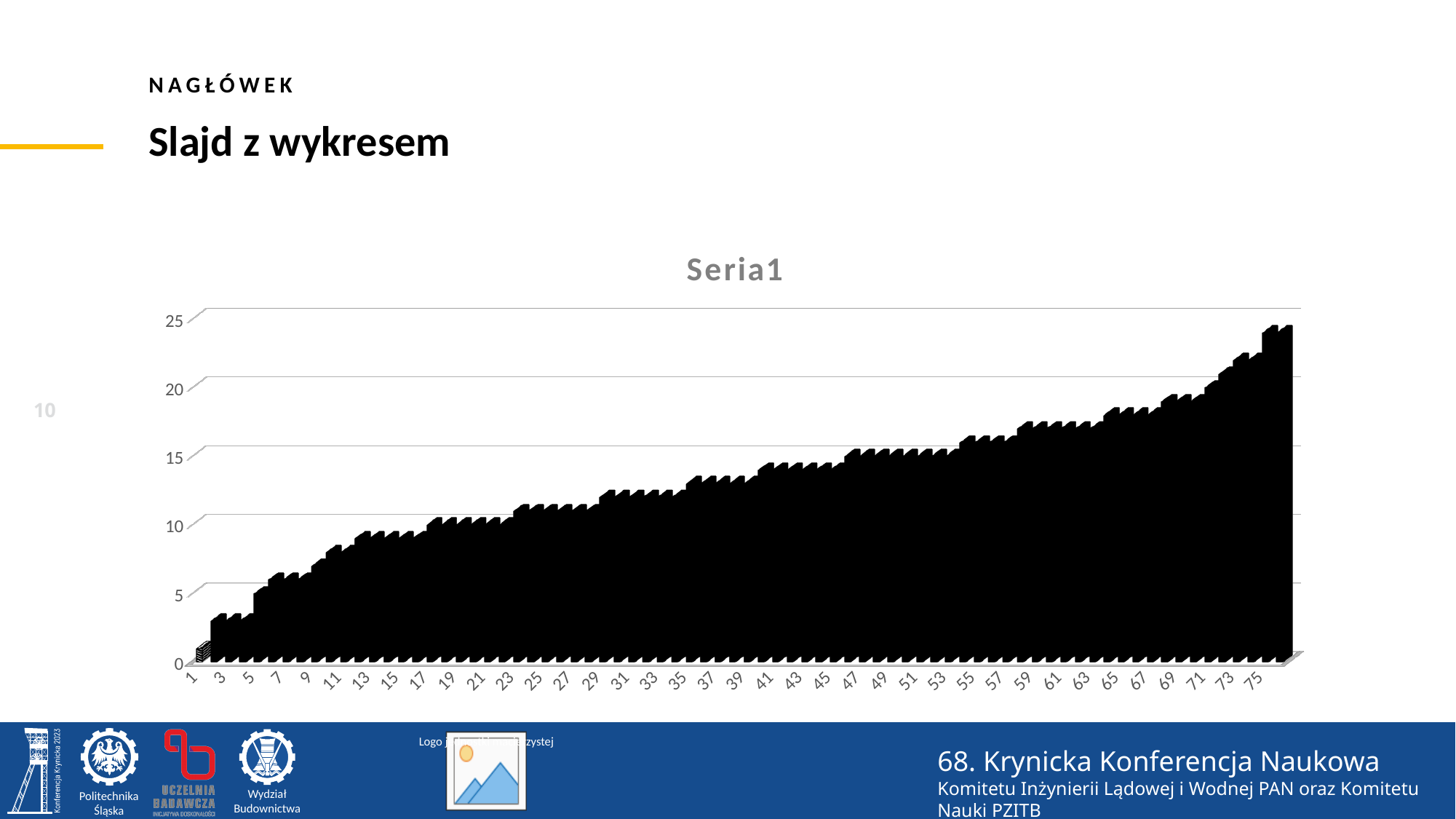
What is the highest value shown on the vertical axis? 25 Which has the larger value, category 1 or category 75? category 75 Which has the larger value, category 21 or category 61? category 61 What is the title of the chart? Seria1 Is the value for category 75 greater or less than 20? greater Is the value for category 5 greater or less than 10? less Is the value for category 39 greater or less than 10? greater Do the values generally rise or fall as the category number increases along the x axis? rise What kind of chart is shown on the slide? bar chart